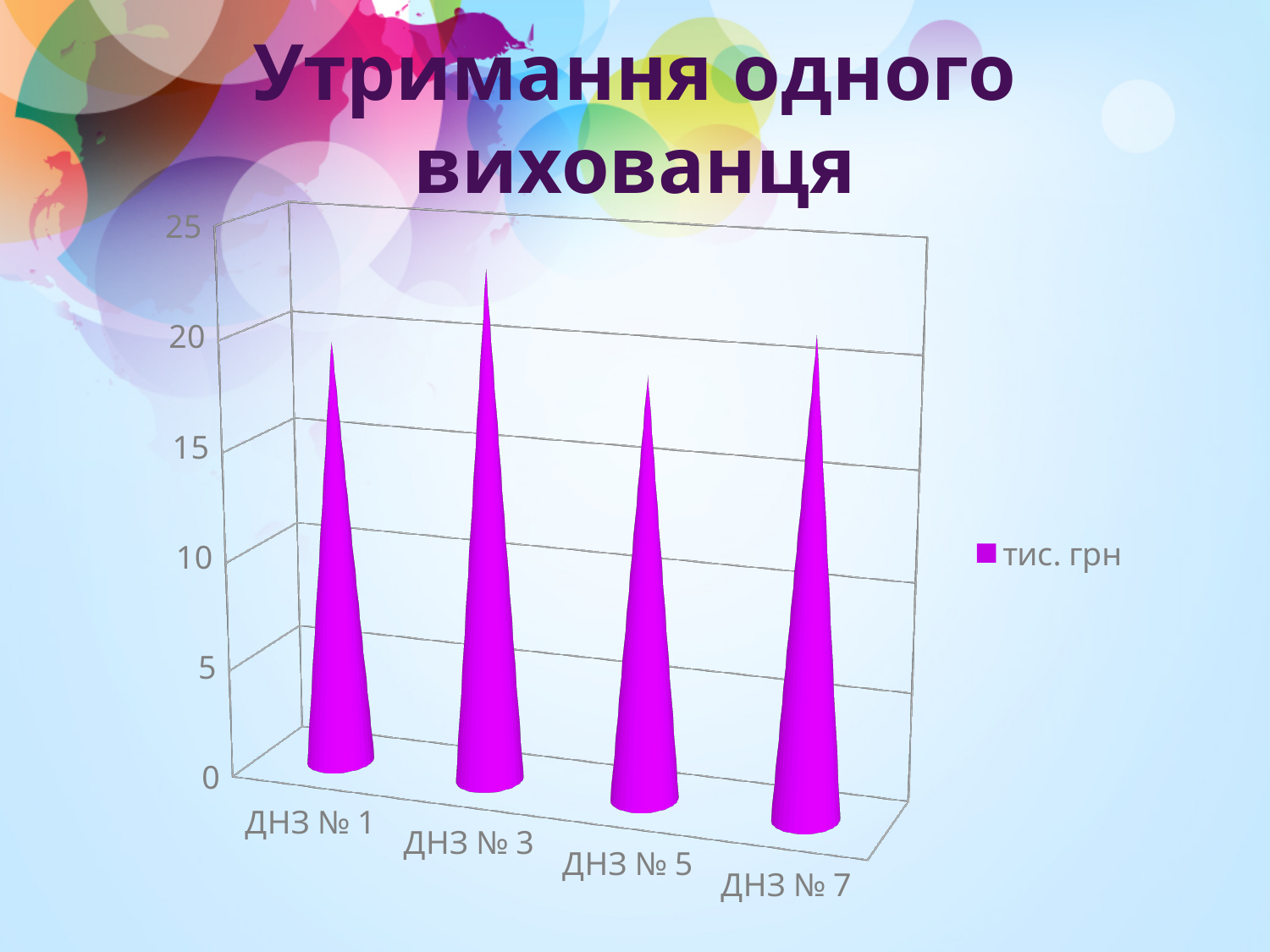
What is the legend entry of the chart? тис. грн What kind of chart is shown on the slide? bar chart What is the title of the chart on the slide? Утримання одного вихованця Is the value for ДНЗ № 5 greater or less than 15? greater Which is larger, the value for ДНЗ № 7 or the value for ДНЗ № 5? ДНЗ № 7 Which is larger, the value for ДНЗ № 3 or the value for ДНЗ № 5? ДНЗ № 3 Is the value for ДНЗ № 3 greater or less than 20? greater Which category has the lowest value? ДНЗ № 5 Is the value for ДНЗ № 5 greater or less than 20? less How many series does the legend list? 1 How many categories are shown on the x axis of the chart? 4 Which category has the highest value? ДНЗ № 3